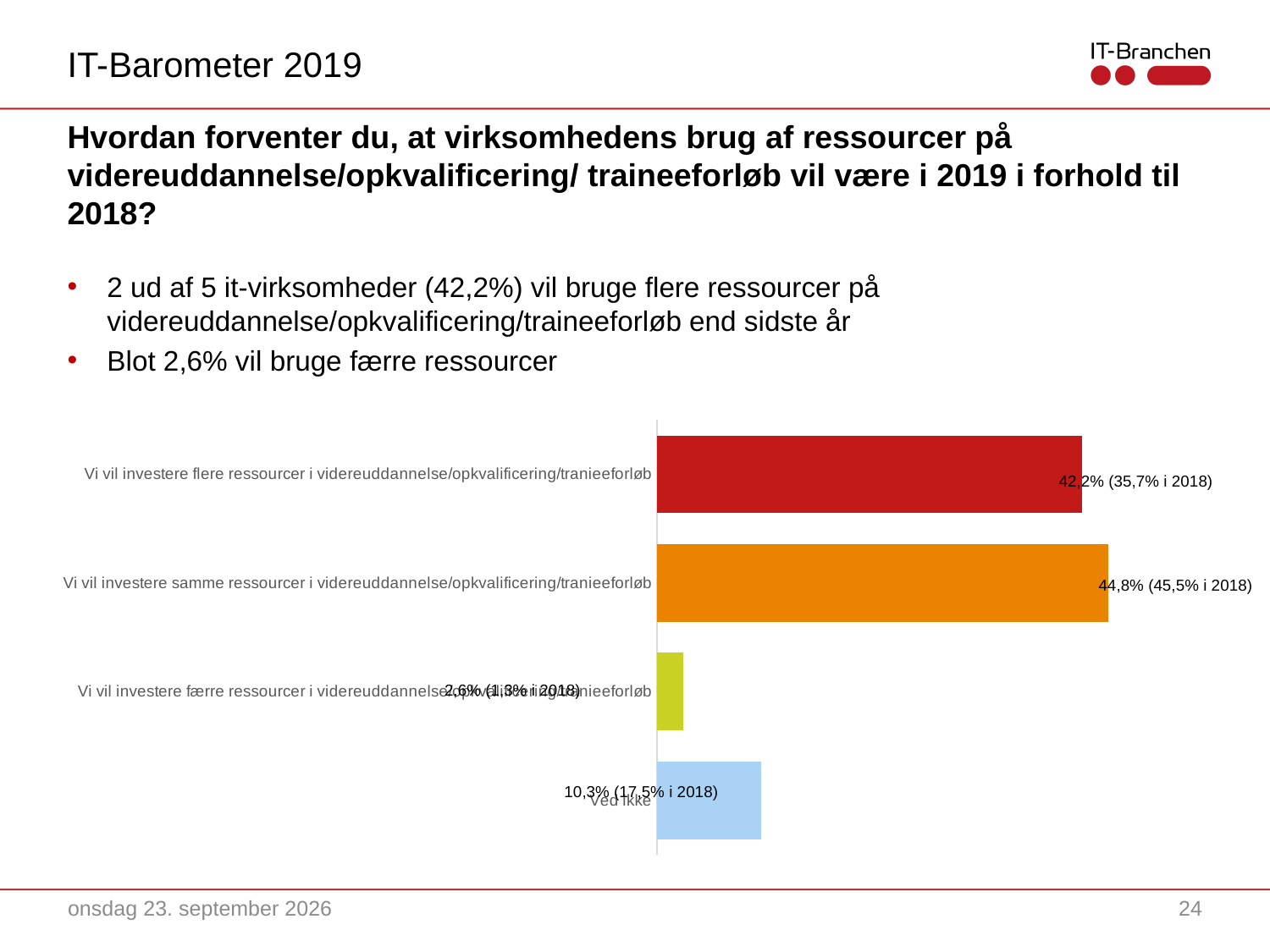
What is the 2019 value for "Vi vil investere samme ressourcer i videreuddannelse/opkvalificering/tranieeforløb"? 44,8% Which category has the lowest 2019 value? Vi vil investere færre ressourcer i videreuddannelse/opkvalificering/tranieeforløb What kind of chart is shown on the slide? bar chart What is the difference between the 2019 values for "Vi vil investere samme ressourcer" and "Vi vil investere flere ressourcer"? 2,6% What was the 2018 value shown in the label for "Ved ikke"? 17,5% What was the 2018 value shown in the label for "Vi vil investere flere ressourcer i videreuddannelse/opkvalificering/tranieeforløb"? 35,7% Which category has the highest 2019 value? Vi vil investere samme ressourcer i videreuddannelse/opkvalificering/tranieeforløb Which is larger: the 2019 value for "Ved ikke" or the 2019 value for "Vi vil investere færre ressourcer"? Ved ikke What is the 2019 value for "Ved ikke"? 10,3% What is the 2019 value for "Vi vil investere flere ressourcer i videreuddannelse/opkvalificering/tranieeforløb"? 42,2% How many categories does the bar chart show? 4 What colour is the bar for "Vi vil investere samme ressourcer i videreuddannelse/opkvalificering/tranieeforløb"? orange